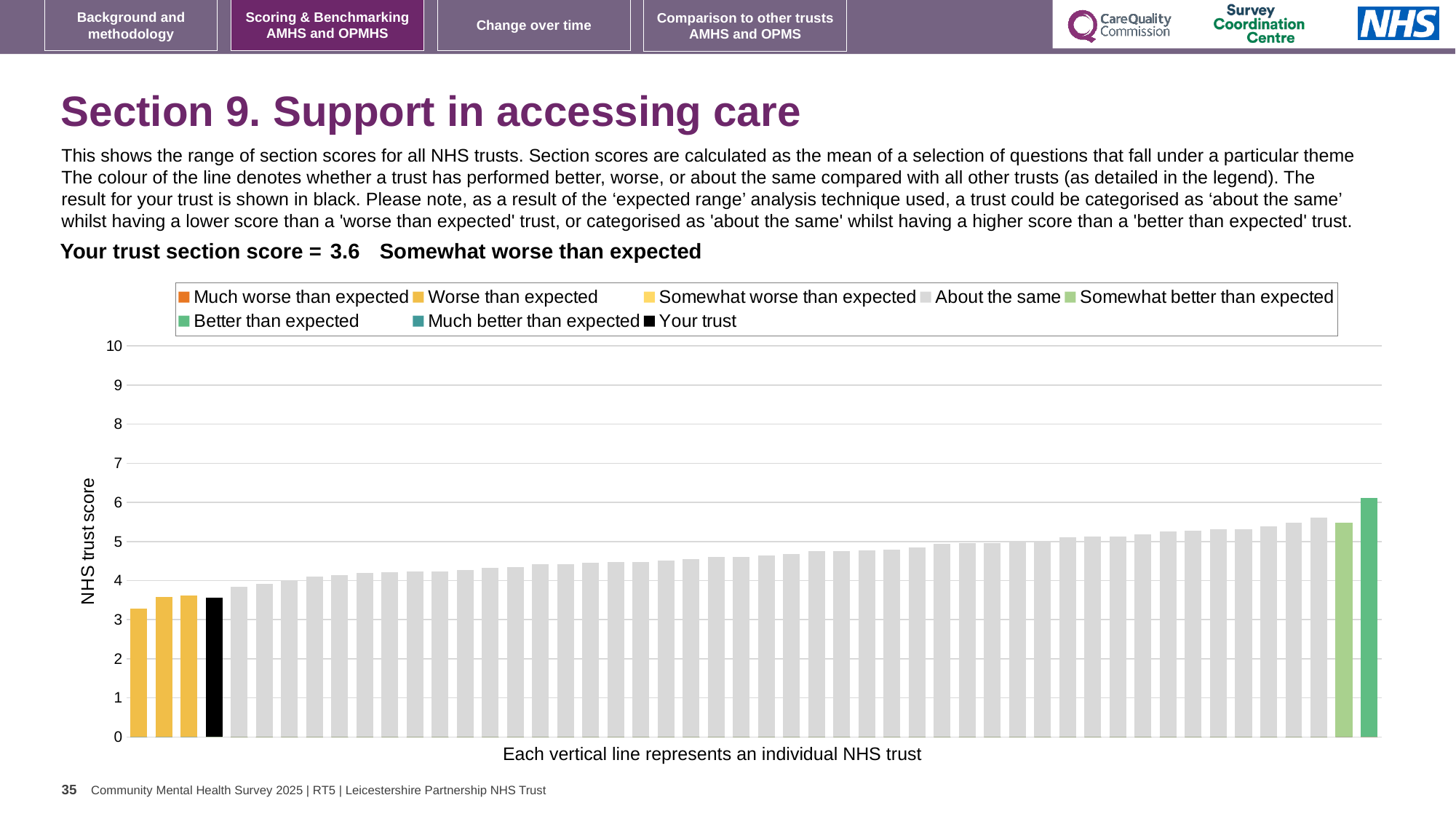
Is the value of the tallest bar greater or less than 5? greater What is the label on the y axis of the chart? NHS trust score Which performance category is your trust placed in for this section? Somewhat worse than expected Is the value for your trust (the black bar) greater or less than 4? less What is the section score for your trust? 3.6 How many bars are coloured in the 'Worse than expected' yellow colour? 3 Do the trust scores rise or fall from left to right along the x axis? rise What kind of chart is shown on the slide? bar chart How many bars are coloured green (better than expected categories)? 2 How many entries does the chart legend list? 8 Which bar is taller: the black 'Your trust' bar or the leftmost yellow bar? the black 'Your trust' bar Is the value of the leftmost bar greater or less than 4? less